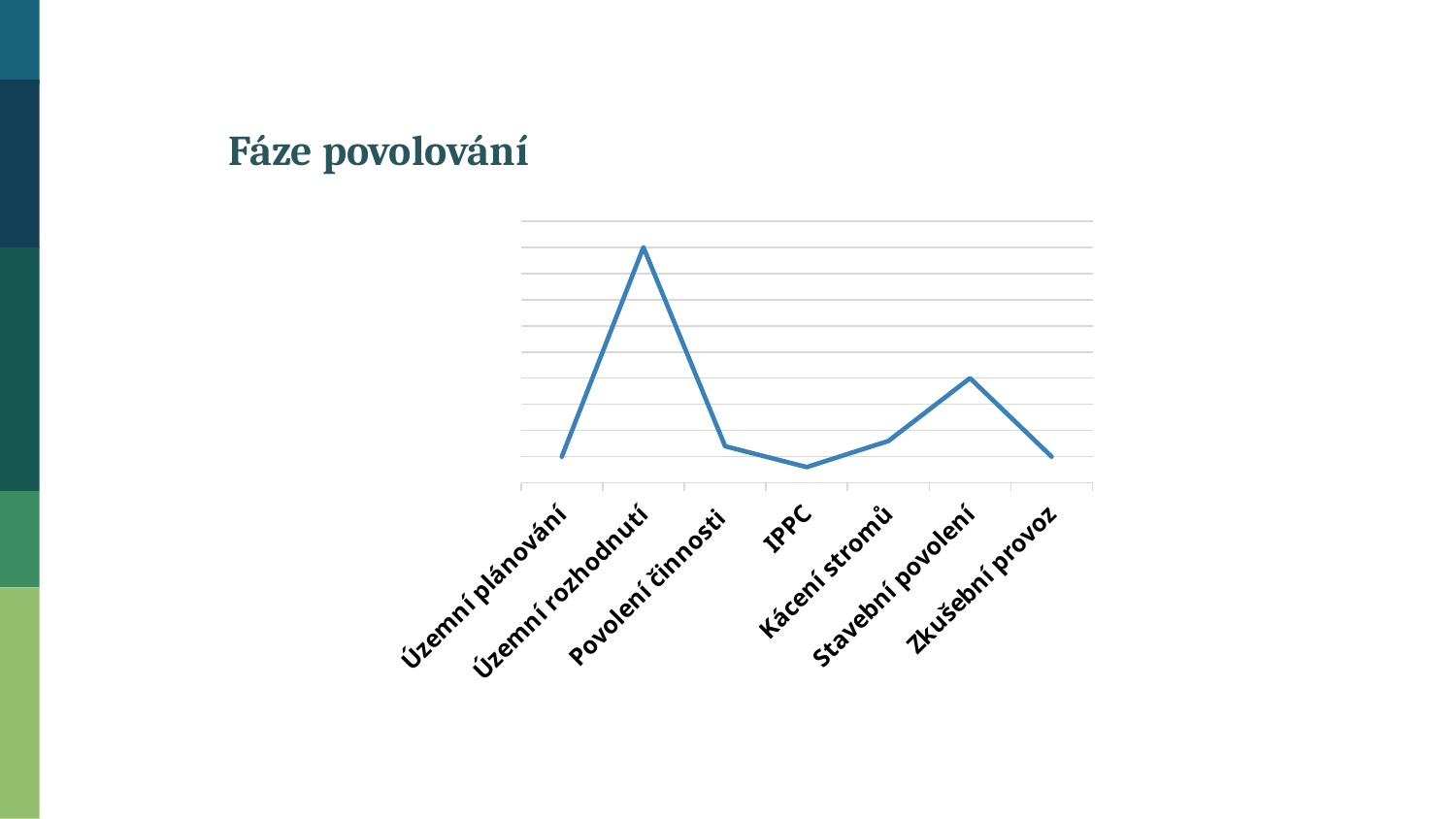
Does the line rise or fall from IPPC to Stavební povolení? rise What kind of chart is shown on the slide? line chart Which is larger, the value for Územní rozhodnutí or the value for Stavební povolení? Územní rozhodnutí How many data series (lines) are plotted in the chart? 1 Does the line rise or fall from Územní plánování to Územní rozhodnutí? rise Which category has the highest value in the chart? Územní rozhodnutí Which is larger, the value for Stavební povolení or the value for Zkušební provoz? Stavební povolení How many categories are plotted along the x axis of the chart? 7 What is the label of the first category on the x axis? Územní plánování Which is larger, the value for IPPC or the value for Kácení stromů? Kácení stromů What is the title of the slide containing the chart? Fáze povolování Does the line rise or fall from Územní rozhodnutí to IPPC? fall